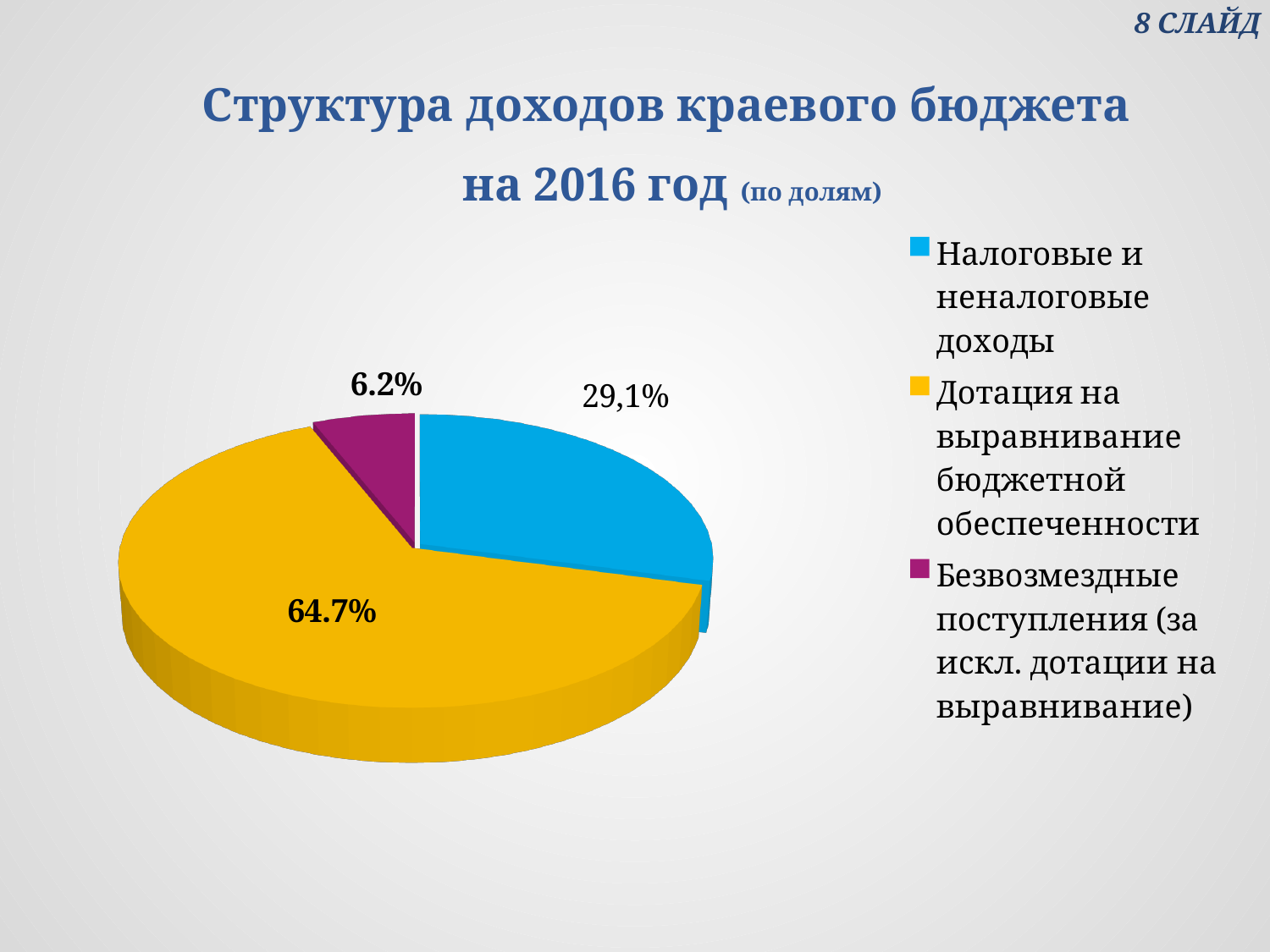
How many entries does the legend list? 3 What colour is the slice for "Налоговые и неналоговые доходы"? blue Which category has the smallest slice of the pie? Безвозмездные поступления (за искл. дотации на выравнивание) What kind of chart is shown on the slide? pie chart What share of the pie does "Дотация на выравнивание бюджетной обеспеченности" have? 64.7% Which is larger: the share of "Налоговые и неналоговые доходы" or the share of "Безвозмездные поступления (за искл. дотации на выравнивание)"? Налоговые и неналоговые доходы Which category has the largest slice of the pie? Дотация на выравнивание бюджетной обеспеченности What is the title of the chart on the slide? Структура доходов краевого бюджета на 2016 год (по долям) What share of the pie does "Налоговые и неналоговые доходы" have? 29,1% What is the difference in percentage points between the share of "Дотация на выравнивание бюджетной обеспеченности" and the share of "Налоговые и неналоговые доходы"? 35.6 What share of the pie does "Безвозмездные поступления (за искл. дотации на выравнивание)" have? 6.2% How many slices does the pie chart have? 3